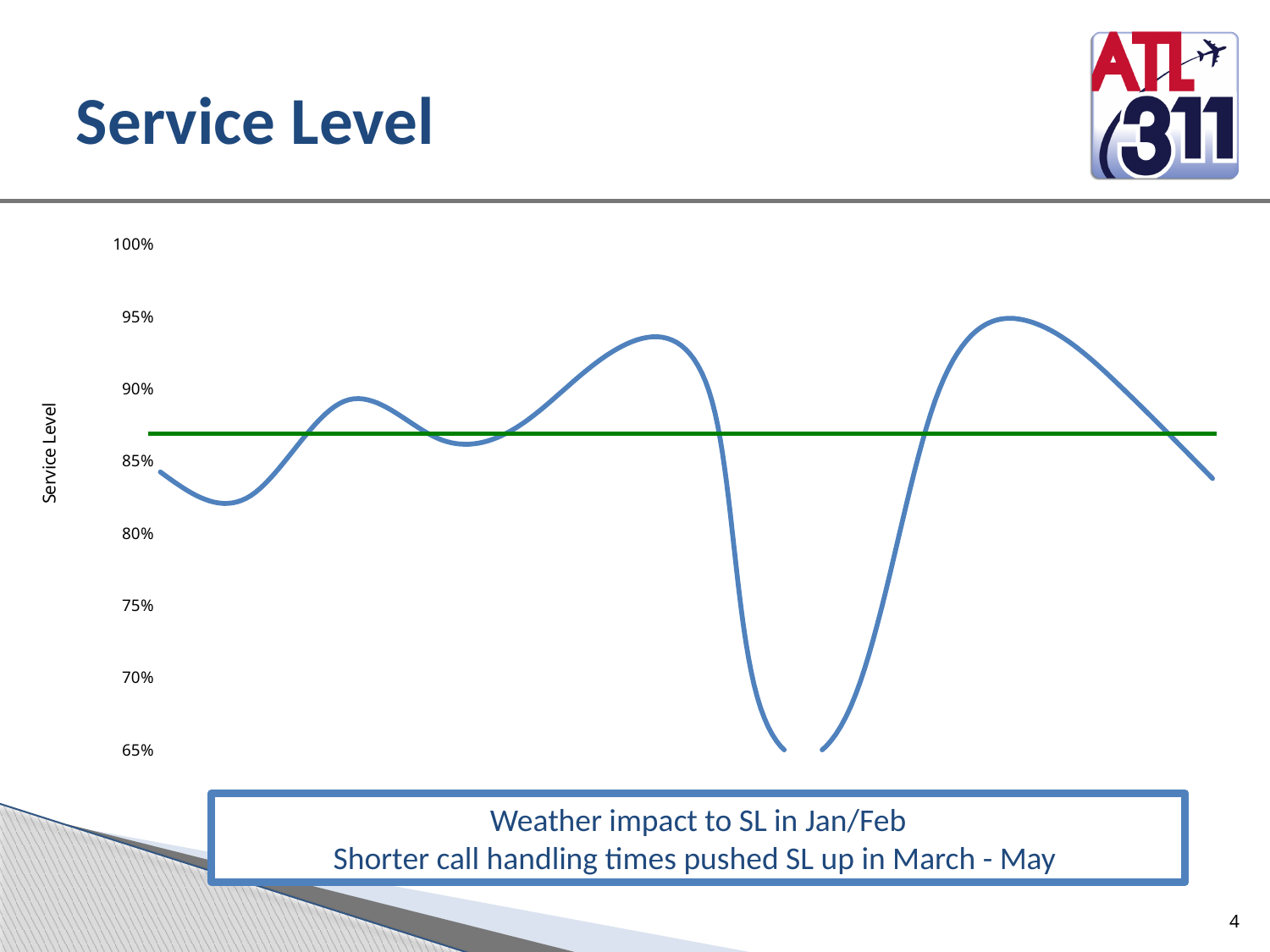
Is the value at the far left end of the blue line greater or less than 90%? less Does the blue line rise or fall at the far right end of the chart? fall Is the value at the far right end of the blue line greater or less than 80%? greater Is the green horizontal line greater or less than 85%? greater What is the highest value shown on the vertical axis? 100% What colour is the horizontal straight line drawn across the chart? green What is the lowest value shown on the vertical axis? 65% What is the label on the vertical axis of the chart? Service Level What kind of chart is shown on the slide? line chart